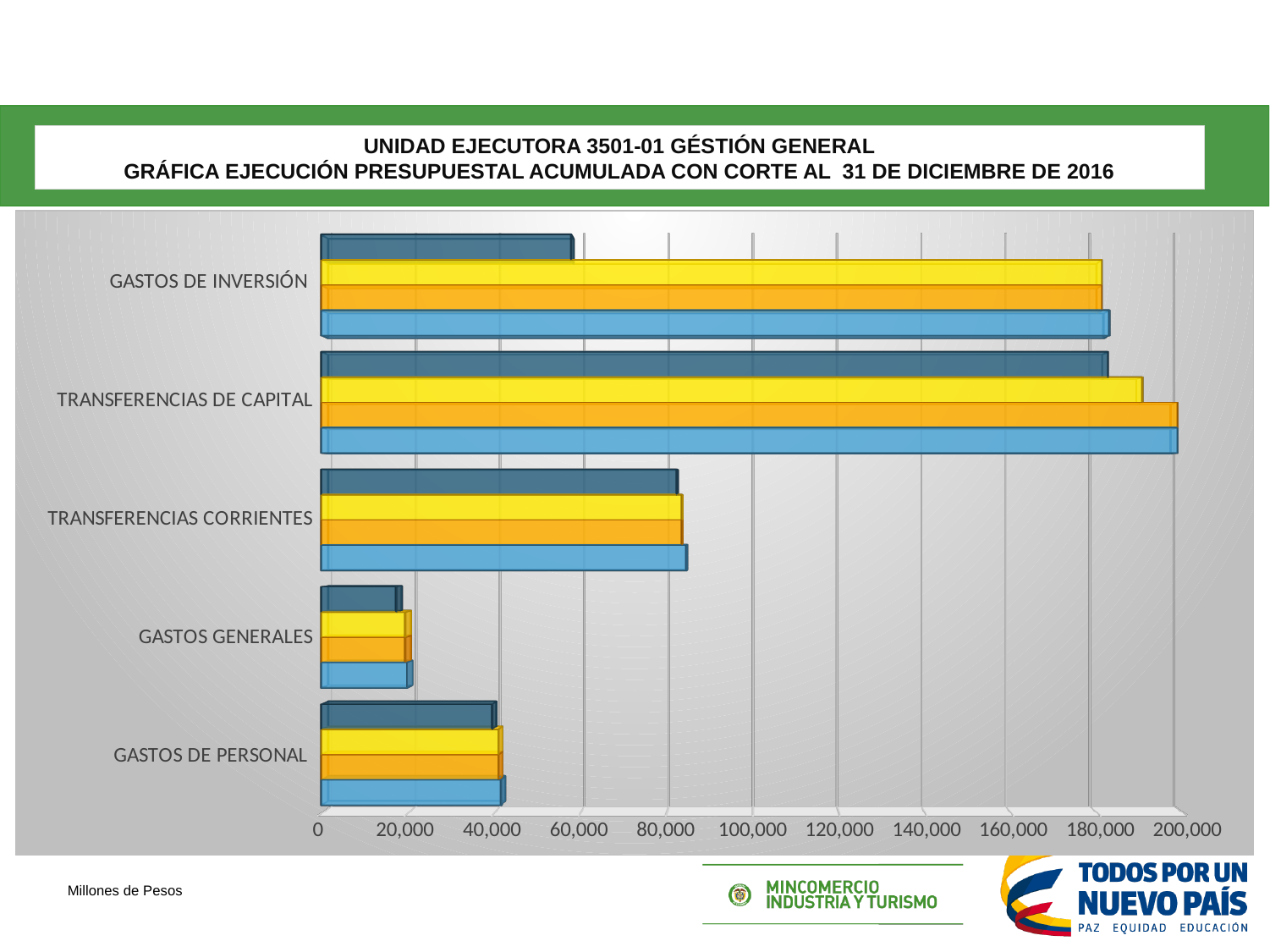
How many categories are shown on the vertical axis of the chart? 5 Which category has larger values, TRANSFERENCIAS CORRIENTES or GASTOS DE PERSONAL? TRANSFERENCIAS CORRIENTES What is the highest value shown on the horizontal axis of the chart? 200,000 Is the value of the dark blue bar for GASTOS DE INVERSIÓN greater or less than 80,000? less Which category has the longest bars in the chart? TRANSFERENCIAS DE CAPITAL Is the value of the light blue bar for TRANSFERENCIAS CORRIENTES greater or less than 60,000? greater How many bars are plotted for each category in the chart? 4 Is the value of the light blue bar for GASTOS GENERALES greater or less than 40,000? less What kind of chart is shown on the slide? bar chart For GASTOS DE INVERSIÓN, which bar is longer, the dark blue bar or the yellow bar? the yellow bar Which category has the shortest bars in the chart? GASTOS GENERALES